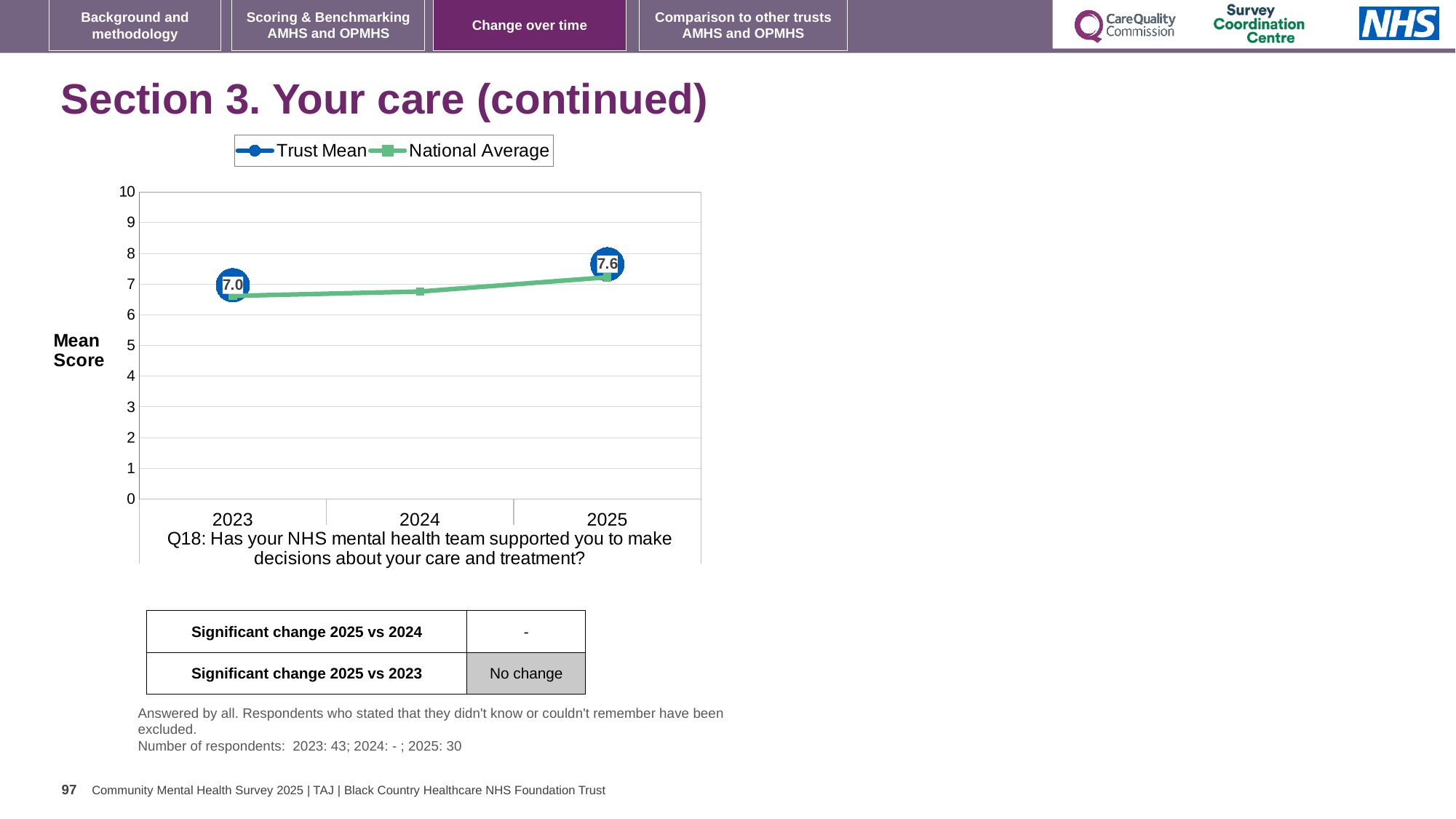
What is the Trust Mean score for 2023? 7.0 What is the label on the y axis of the chart? Mean Score Which year has the higher Trust Mean score, 2023 or 2025? 2025 Is the National Average value for 2025 greater or less than 8? less By how much did the Trust Mean score change from 2023 to 2025? 0.6 In which year shown is the Trust Mean score highest? 2025 What kind of chart is shown on the slide? line chart How many series does the chart legend list? 2 Does the Trust Mean score rise or fall from 2023 to 2025? rise Is the National Average value for 2024 greater or less than 5? greater What is the Trust Mean score for 2025? 7.6 How many years are shown on the x axis of the chart? 3